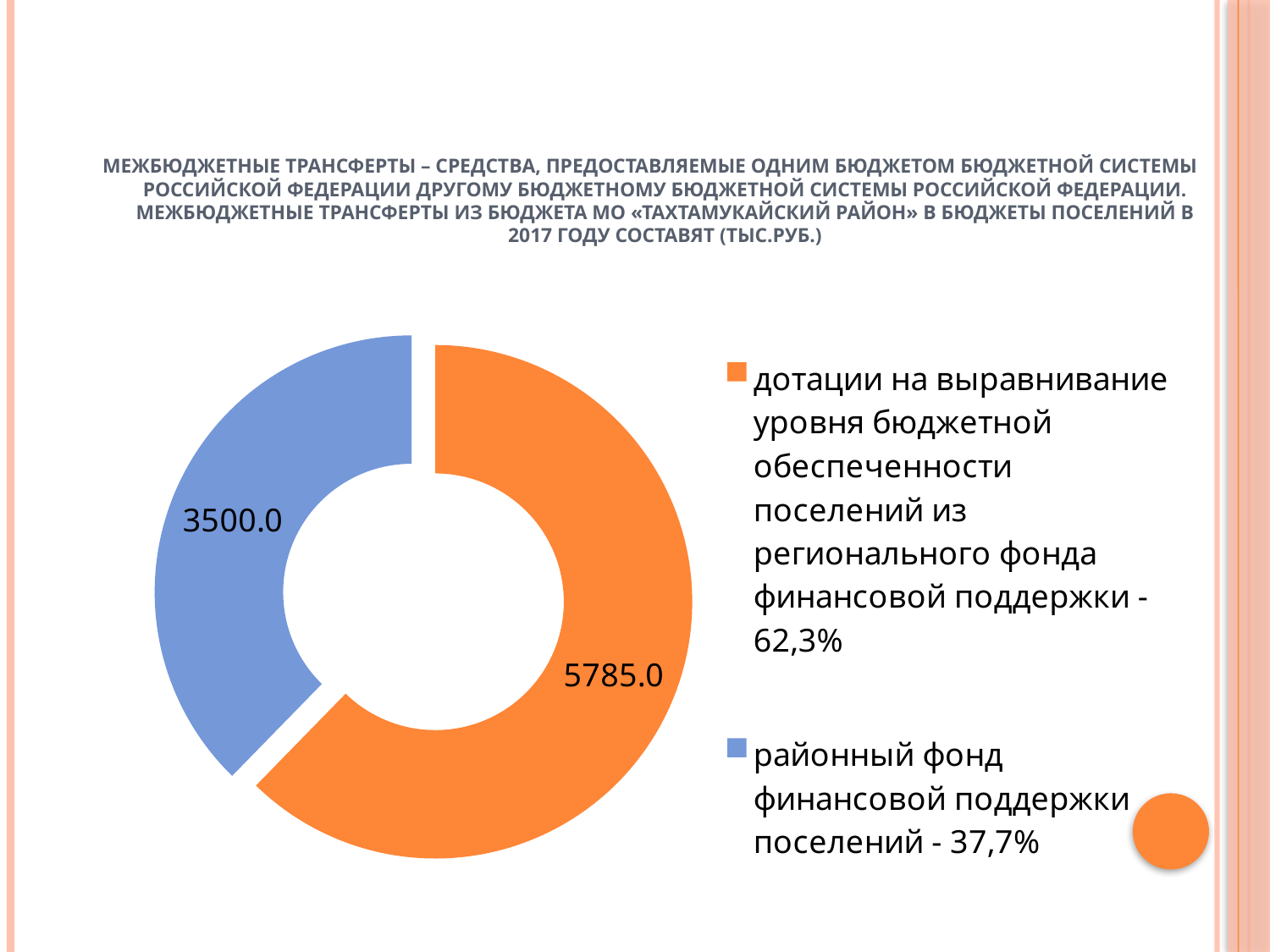
Which is larger: the value for «дотации на выравнивание...» or the value for «районный фонд финансовой поддержки поселений»? дотации на выравнивание уровня бюджетной обеспеченности поселений из регионального фонда финансовой поддержки What type of chart is shown on the slide? doughnut chart What colour is the slice for «районный фонд финансовой поддержки поселений»? blue What is the difference between the value for «дотации на выравнивание...» and the value for «районный фонд финансовой поддержки поселений»? 2285.0 Which category has the largest slice of the chart? дотации на выравнивание уровня бюджетной обеспеченности поселений из регионального фонда финансовой поддержки What is the value for «дотации на выравнивание уровня бюджетной обеспеченности поселений из регионального фонда финансовой поддержки»? 5785.0 What is the value for «районный фонд финансовой поддержки поселений»? 3500.0 What share of the chart does «дотации на выравнивание...» represent, according to the legend? 62,3% How many categories does the chart show? 2 What is the total of the two values shown on the chart? 9285.0 What share of the chart does «районный фонд финансовой поддержки поселений» represent, according to the legend? 37,7% Which category has the smallest slice of the chart? районный фонд финансовой поддержки поселений